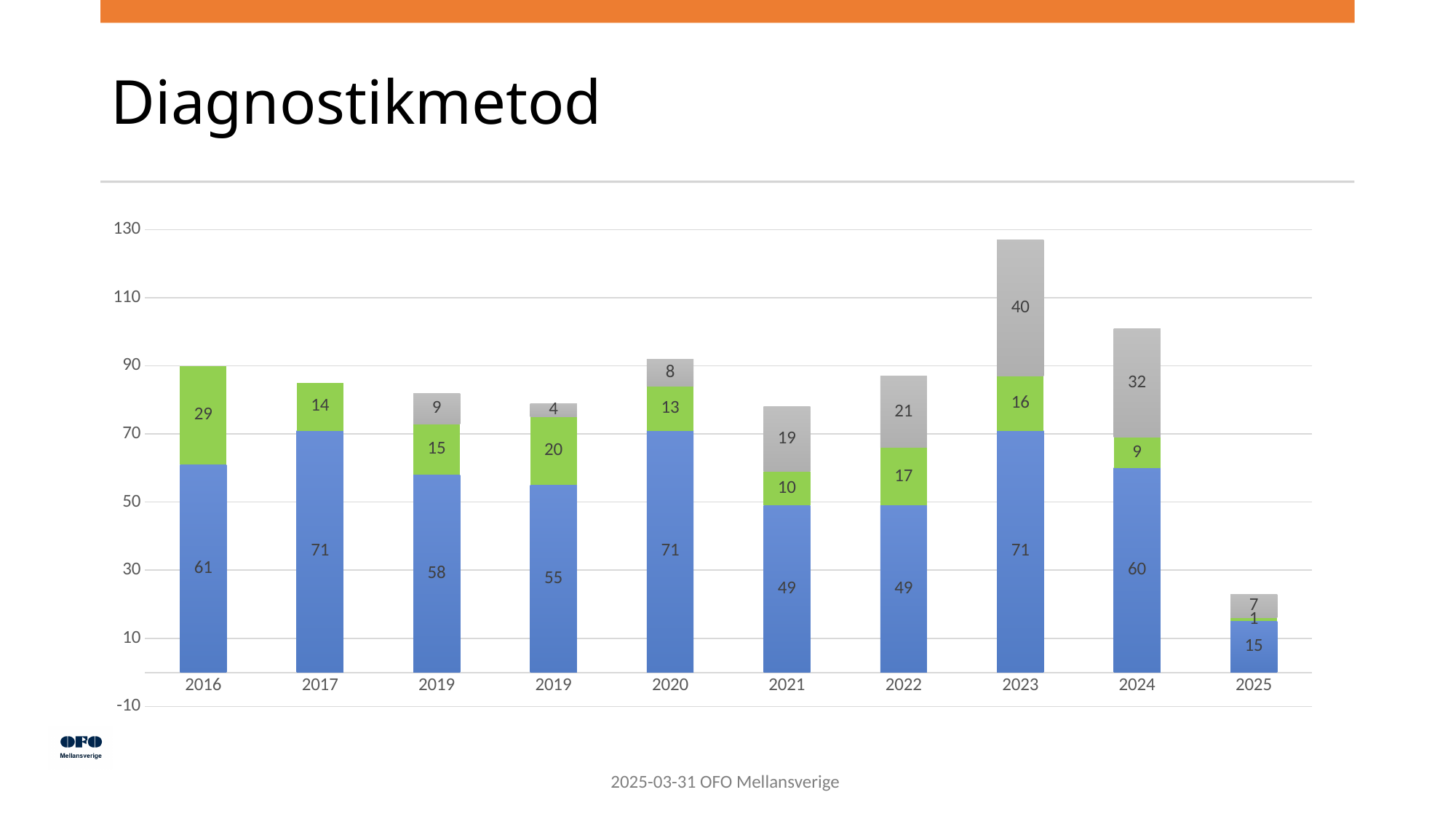
Is the total height of the 2024 bar greater or less than 90? greater Which is larger, the blue segment for 2017 or the blue segment for 2024? 2017 What is the difference between the grey segment for 2023 and the grey segment for 2024? 8 How many bars are shown on the x axis? 10 Which year has the shortest stacked bar overall? 2025 What is the value of the grey segment for 2024? 32 What is the value of the green segment for 2016? 29 What is the total of the stacked bar for 2025? 23 What type of chart is shown on the slide? Stacked bar chart Which year has the tallest stacked bar overall? 2023 What is the value of the blue segment for 2023? 71 What is the total of the stacked bar for 2023? 127